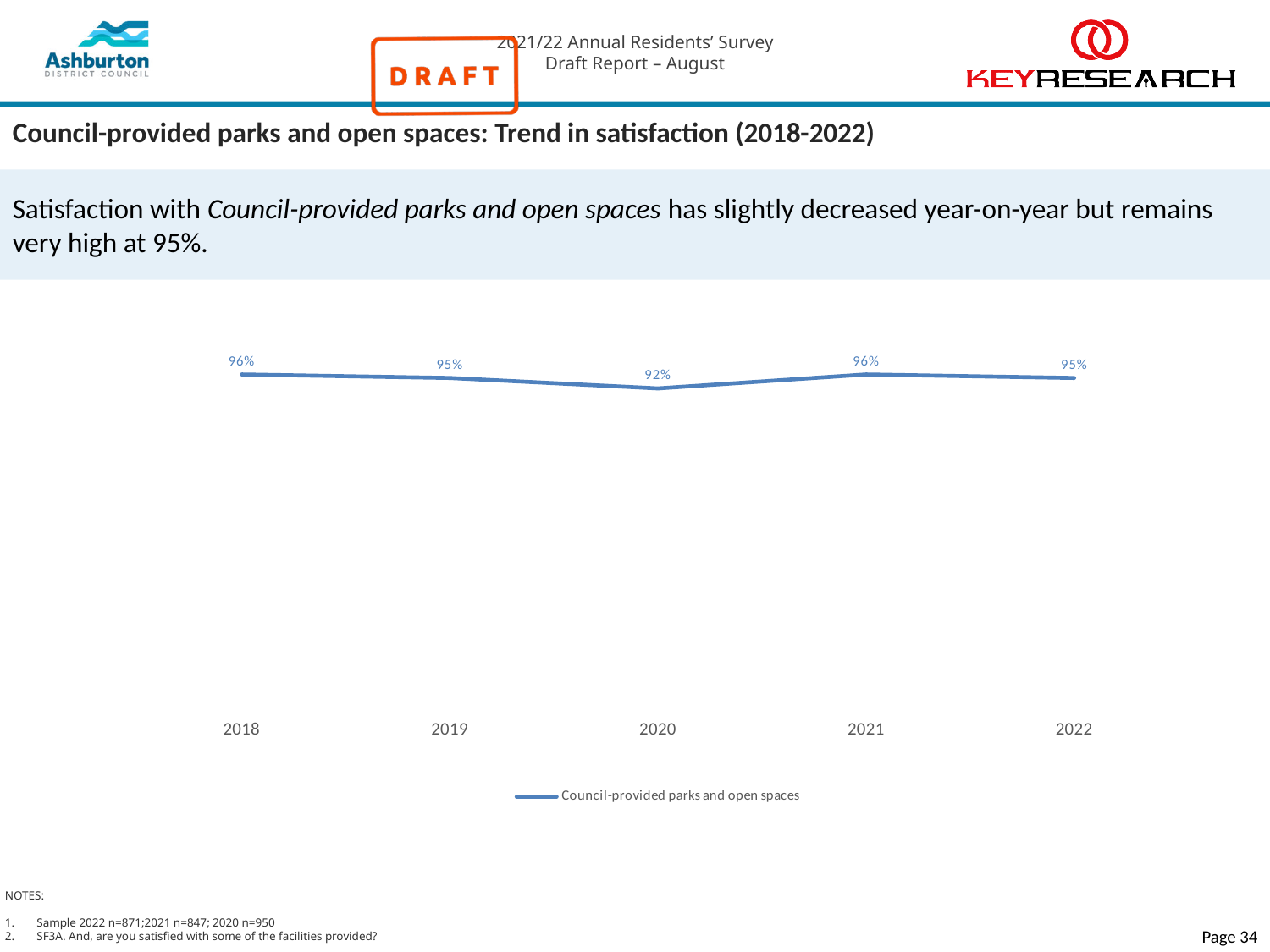
What is the difference between the satisfaction values for 2018 and 2022? 1% What kind of chart is shown on the slide? Line chart How many series does the legend list? 1 What was the satisfaction value for Council-provided parks and open spaces in 2020? 92% What was the satisfaction value for Council-provided parks and open spaces in 2022? 95% Which is larger, the satisfaction value for 2019 or for 2020? 2019 Which year shows the lowest satisfaction value on the chart? 2020 How many years are plotted on the chart? 5 What was the satisfaction value for Council-provided parks and open spaces in 2021? 96% Did the satisfaction value rise or fall from 2021 to 2022? Fall What was the satisfaction value for Council-provided parks and open spaces in 2018? 96% What is the difference between the satisfaction values for 2021 and 2020? 4%